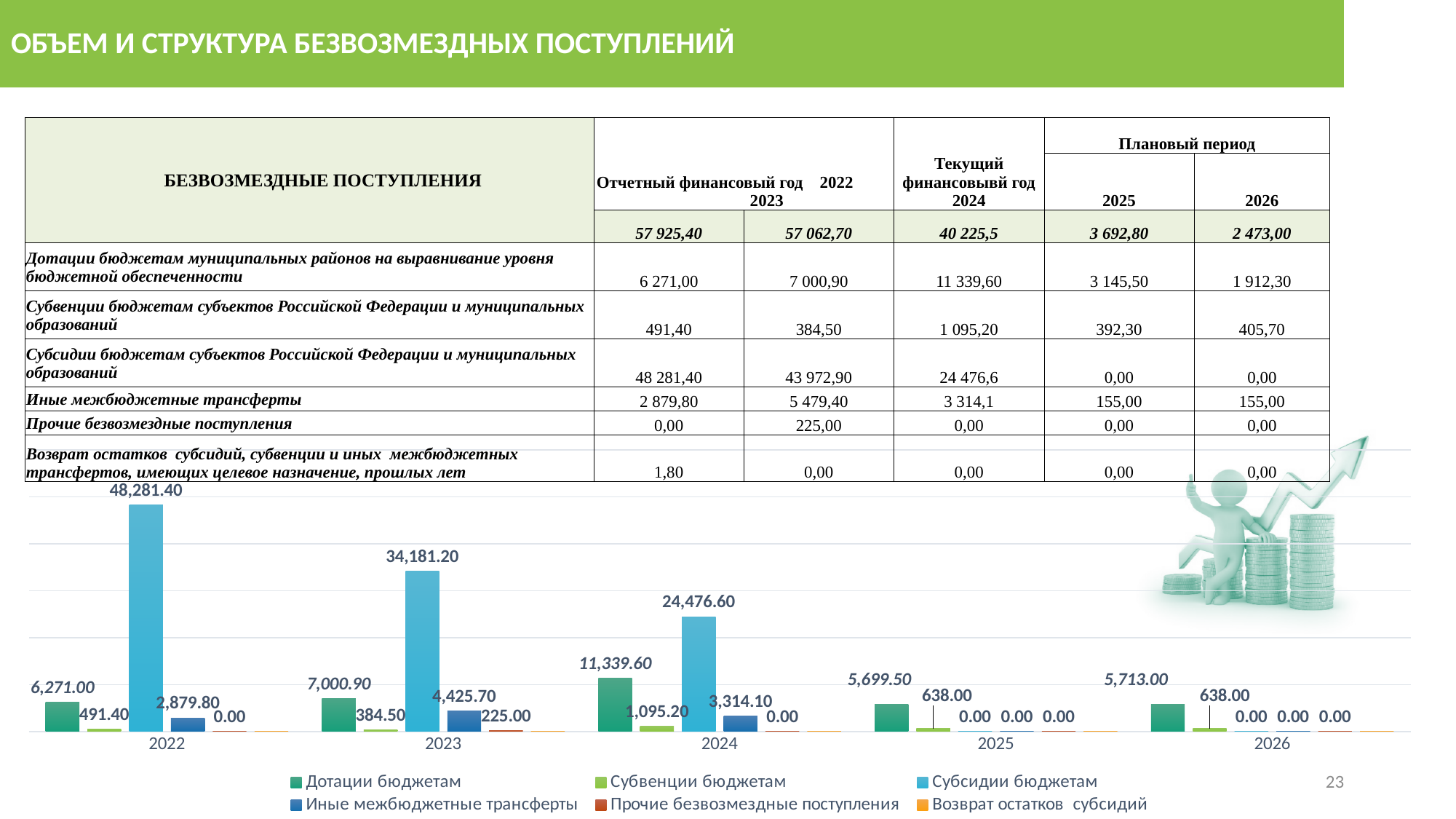
What is the value of Субвенции бюджетам for 2025 in the chart? 638.00 Which year has the larger value for Иные межбюджетные трансферты in the chart, 2022 or 2023? 2023 What is the difference between the Субсидии бюджетам values for 2022 and 2023 in the chart? 14,100.20 How many year categories are shown on the x axis of the chart? 5 What is the difference between the Дотации бюджетам values for 2024 and 2023 in the chart? 4,338.70 What is the value of Прочие безвозмездные поступления for 2023 in the chart? 225.00 What kind of chart is shown at the bottom of the slide? bar chart In which year is the value of Субсидии бюджетам highest in the chart? 2022 How many series does the chart legend list? 6 What is the value of Субсидии бюджетам for 2022 in the chart? 48,281.40 Do the values of Субсидии бюджетам rise or fall from 2022 to 2024 in the chart? fall What is the value of Дотации бюджетам for 2024 in the chart? 11,339.60